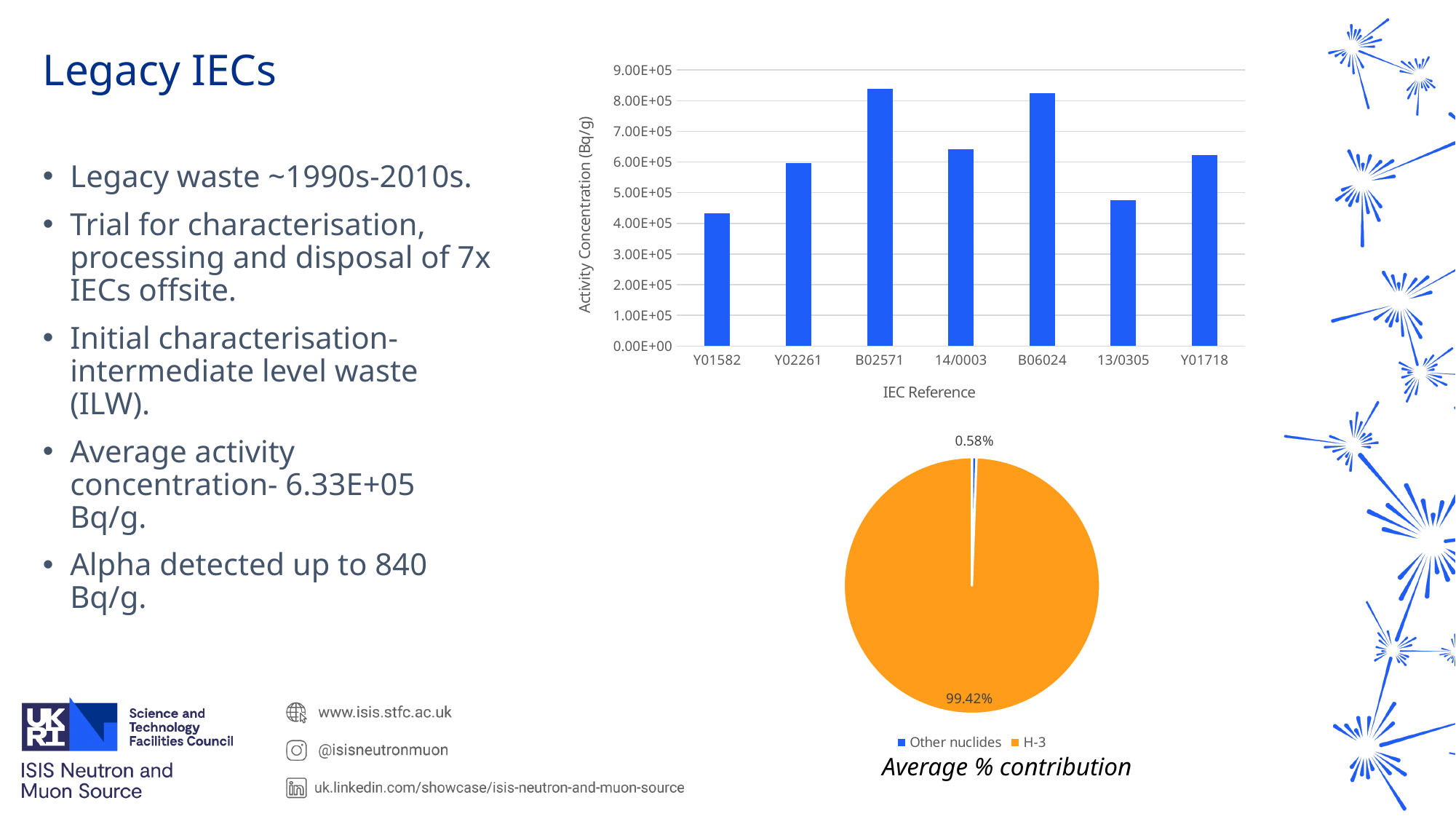
What is the label of the y axis on the bar chart? Activity Concentration (Bq/g) In the bar chart of activity concentration, is the value for Y01582 greater or less than 5.00E+05? less In the bar chart of activity concentration, is the value for 13/0305 greater or less than 5.00E+05? less In the bar chart of activity concentration, which has the larger value, 14/0003 or 13/0305? 14/0003 In the pie chart titled 'Average % contribution', what share does H-3 have? 99.42% In the bar chart of activity concentration, which IEC reference has the lowest value? Y01582 In the pie chart titled 'Average % contribution', what share do Other nuclides have? 0.58% In the bar chart of activity concentration, which has the larger value, Y02261 or B06024? B06024 In the bar chart of activity concentration, how many IEC references are shown on the x axis? 7 In the bar chart of activity concentration, is the value for B02571 greater or less than 8.00E+05? greater How many entries does the legend of the pie chart 'Average % contribution' list? 2 What kind of chart is the top-right chart with the IEC Reference axis? bar chart